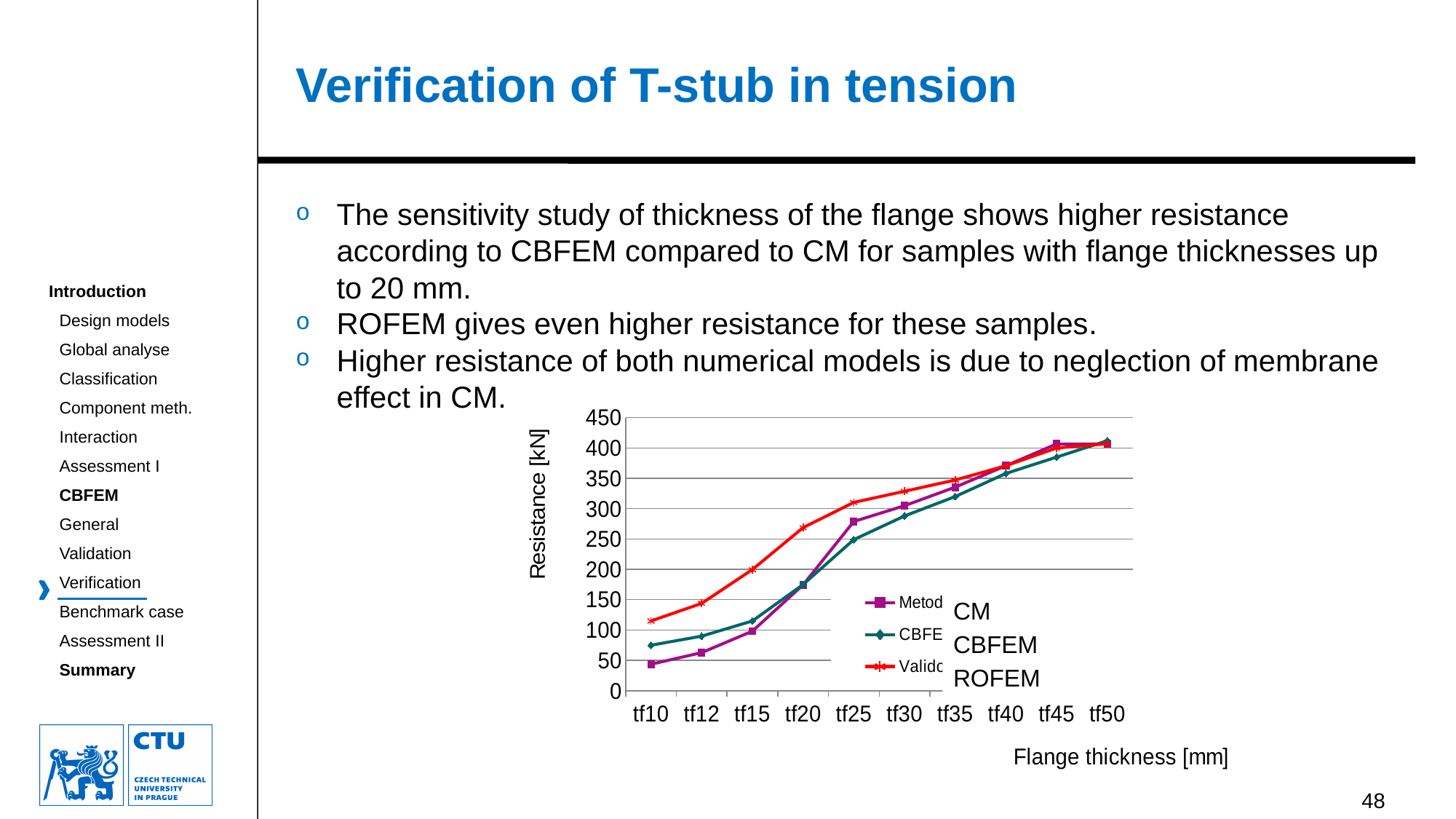
How many series does the chart's legend list? 3 What kind of chart is shown on the slide? line chart Is the CBFEM value at tf40 greater or less than 300? greater Is the ROFEM value at tf10 greater or less than 100? greater How many flange thickness categories are plotted on the x axis? 10 Is the CM value at tf10 greater or less than 100? less What is the label of the chart's vertical axis? Resistance [kN] At tf25, which is larger: the ROFEM value or the CM value? ROFEM Does the CM series rise or fall as flange thickness increases from tf10 to tf50? rise Which series has the lowest value at tf10? CM Which series has the highest value at tf20? ROFEM At tf15, which is larger: the ROFEM value or the CBFEM value? ROFEM